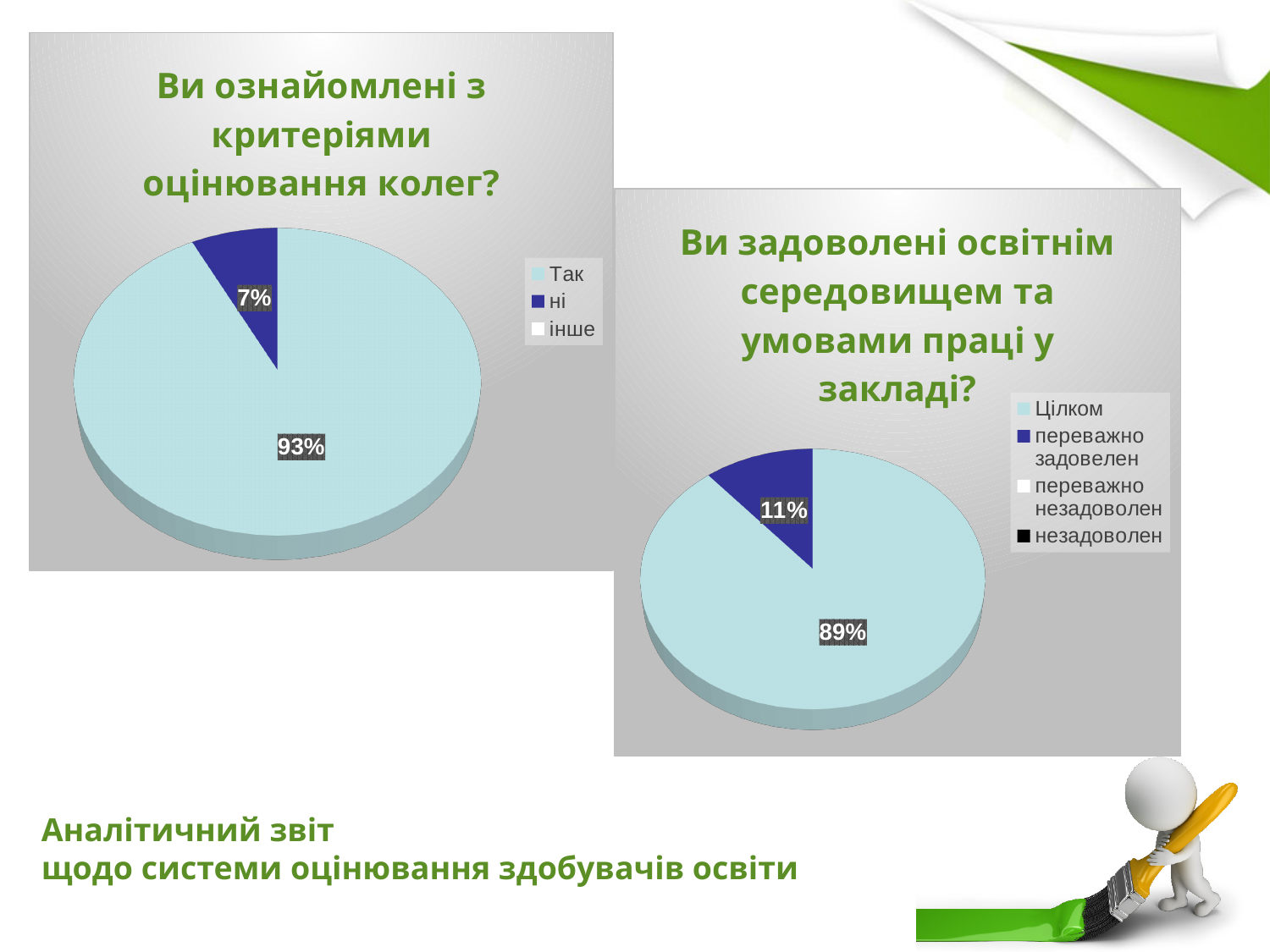
In the left chart 'Ви ознайомлені з критеріями оцінювання колег?', what share of respondents answered 'ні'? 7% In the left chart 'Ви ознайомлені з критеріями оцінювання колег?', what share of respondents answered 'Так'? 93% In the right chart 'Ви задоволені освітнім середовищем та умовами праці у закладі?', which answer has the largest slice? Цілком How many entries does the legend of the left chart 'Ви ознайомлені з критеріями оцінювання колег?' list? 3 What type of chart is the left chart 'Ви ознайомлені з критеріями оцінювання колег?'? Pie chart In the left chart 'Ви ознайомлені з критеріями оцінювання колег?', which answer has the largest slice? Так How many entries does the legend of the right chart 'Ви задоволені освітнім середовищем та умовами праці у закладі?' list? 4 In the left chart 'Ви ознайомлені з критеріями оцінювання колег?', what is the difference in percentage points between 'Так' and 'ні'? 86 In the right chart 'Ви задоволені освітнім середовищем та умовами праці у закладі?', what share of respondents answered 'переважно задоволен'? 11% In the right chart 'Ви задоволені освітнім середовищем та умовами праці у закладі?', what is the difference in percentage points between 'Цілком' and 'переважно задоволен'? 78 In the right chart 'Ви задоволені освітнім середовищем та умовами праці у закладі?', what share of respondents answered 'Цілком'? 89% Which is larger: the 'ні' share in the left chart or the 'переважно задоволен' share in the right chart? переважно задоволен (right chart)